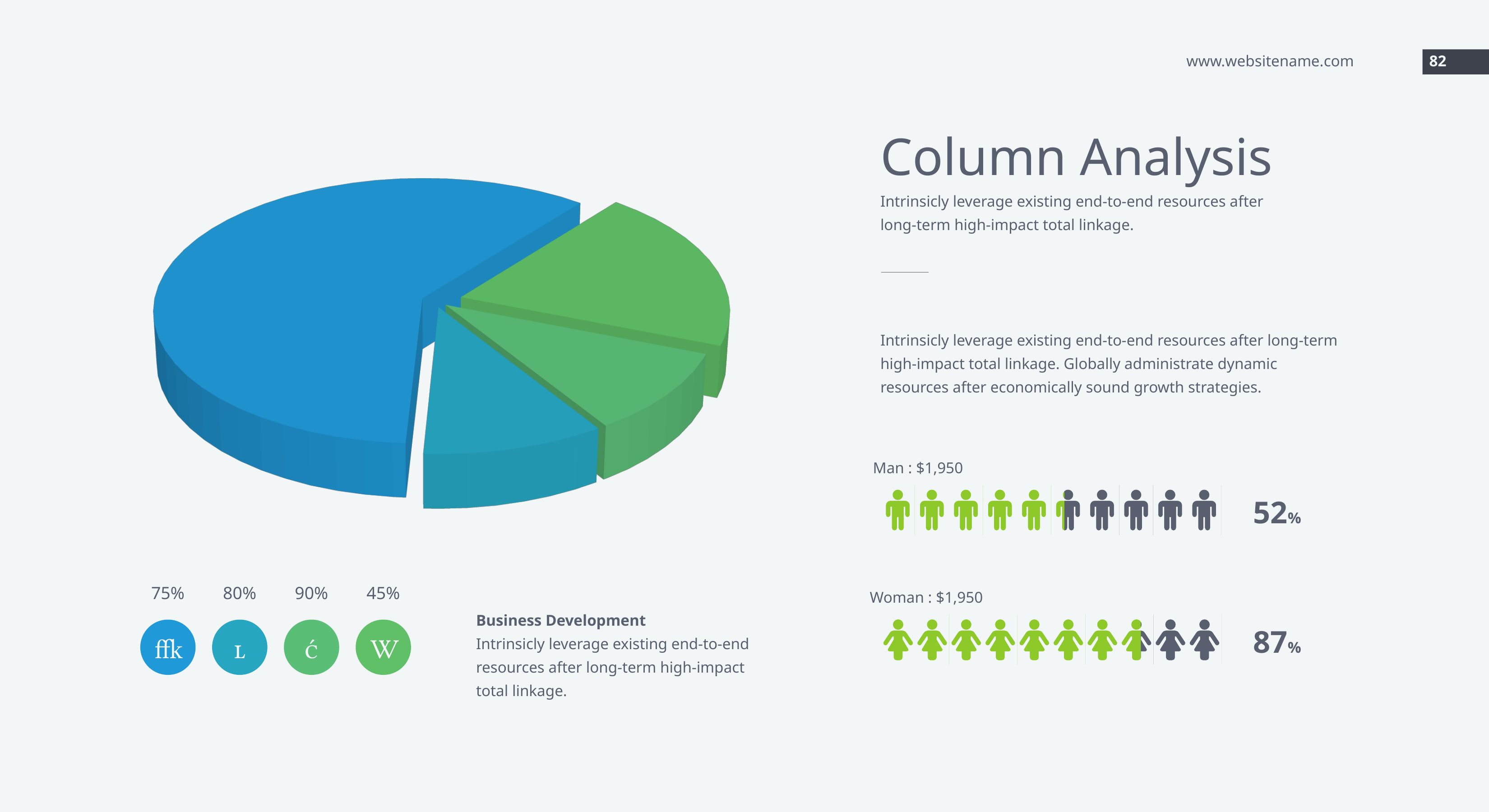
Is the blue slice of the pie chart larger or smaller than the teal slice? larger In the pictograph on the right, what percentage is shown for Man? 52% In the pictograph on the right, what percentage is shown for Woman? 87% What kind of chart is shown on the left of the slide? pie chart In the pictograph on the right, which group has the higher percentage, Man or Woman? Woman How many slices does the pie chart have? 4 Does the largest slice of the pie chart take up more or less than half of the pie? more In the pictograph on the right, what is the difference between the Woman and Man percentages? 35% Is the pie chart drawn in 3D or flat 2D? 3D Does the pie chart have a legend? No Which slice of the pie chart is the largest? the blue slice